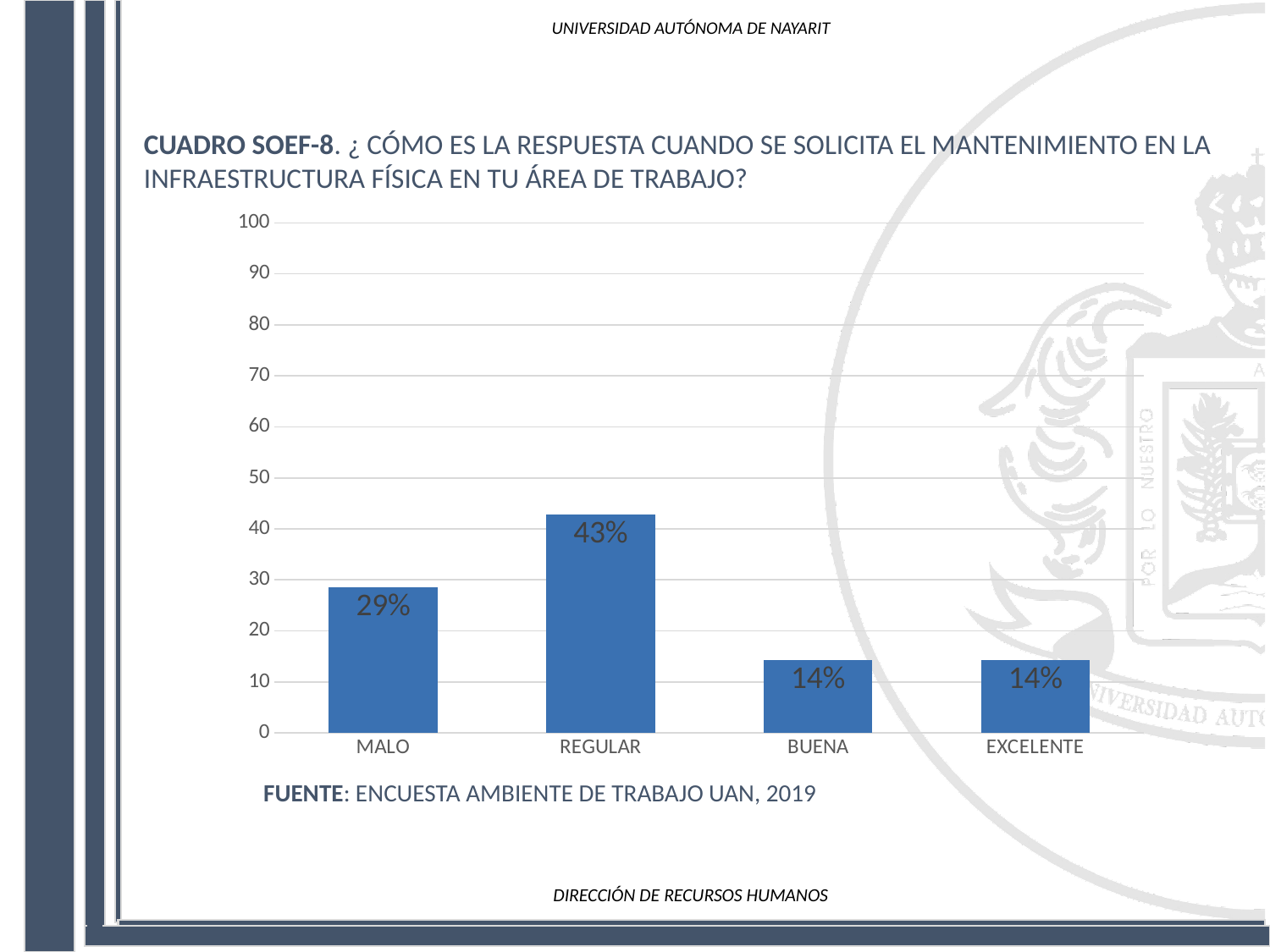
What is the difference between the values for MALO and BUENA? 15% Which is larger, the value for MALO or the value for EXCELENTE? MALO What is the value for EXCELENTE? 14% How many categories are shown on the x axis? 4 What is the difference between the values for REGULAR and MALO? 14% What kind of chart is shown on the slide? bar chart Is the value for REGULAR greater or less than 40? greater Is the value for MALO greater or less than 30? less What is the value for BUENA? 14% Which category has the highest value? REGULAR What is the value for REGULAR? 43% What is the value for MALO? 29%